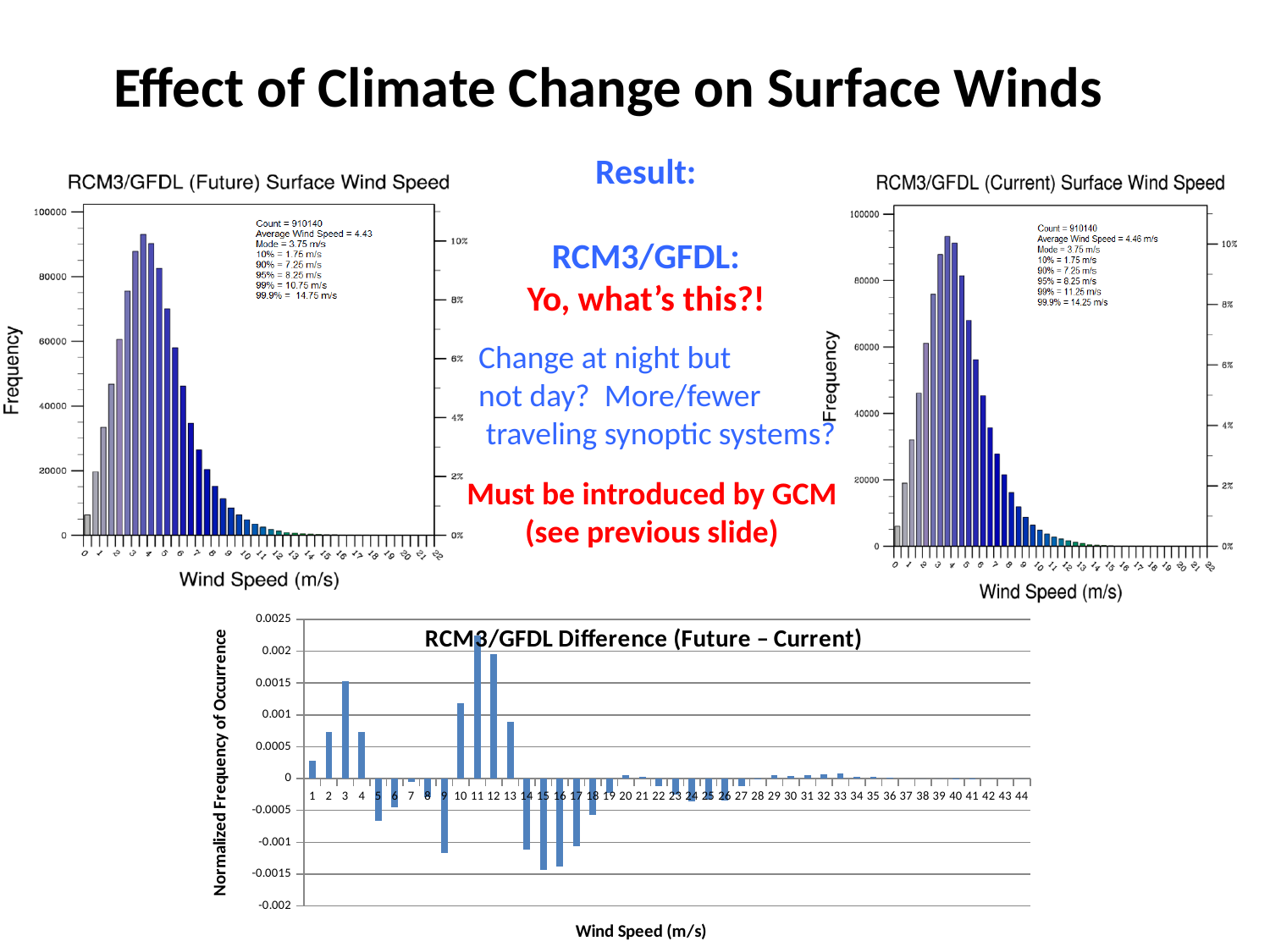
In the bottom chart 'RCM3/GFDL Difference (Future – Current)', is the value for wind speed 15 greater or less than -0.001? less In the top-left chart 'RCM3/GFDL (Future) Surface Wind Speed', what is the label of the x axis? Wind Speed (m/s) What kind of chart is the bottom chart titled 'RCM3/GFDL Difference (Future – Current)'? bar chart In the bottom chart 'RCM3/GFDL Difference (Future – Current)', which has the larger value, wind speed 3 or wind speed 10? wind speed 3 In the top-right chart 'RCM3/GFDL (Current) Surface Wind Speed', what is the Average Wind Speed given in the text box? 4.46 m/s In the bottom chart 'RCM3/GFDL Difference (Future – Current)', is the value for wind speed 9 greater or less than -0.001? less In the bottom chart 'RCM3/GFDL Difference (Future – Current)', is the value for wind speed 10 greater or less than 0.001? greater In the bottom chart 'RCM3/GFDL Difference (Future – Current)', what is the label of the y axis? Normalized Frequency of Occurrence In the top-right chart 'RCM3/GFDL (Current) Surface Wind Speed', what is the Count given in the text box? 910140 In the top-left chart 'RCM3/GFDL (Future) Surface Wind Speed', what is the 99% wind speed value given in the text box? 10.75 m/s In the bottom chart 'RCM3/GFDL Difference (Future – Current)', how many wind speed categories are shown on the x axis? 44 In the top-left chart 'RCM3/GFDL (Future) Surface Wind Speed', what is the Average Wind Speed given in the text box? 4.43